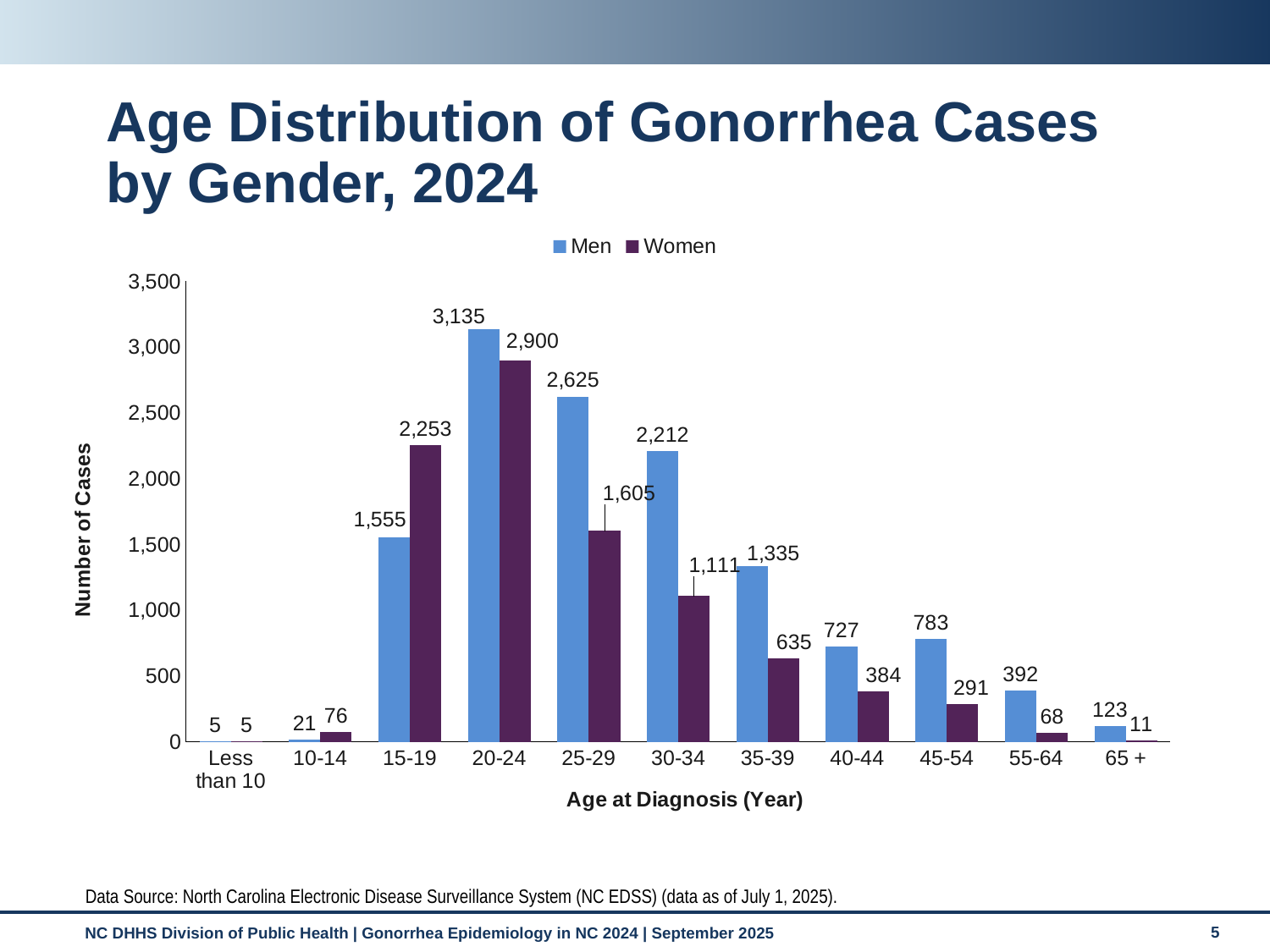
How many age groups are shown on the x axis? 11 Do the number of cases for men rise or fall from the 20-24 age group to the 65 + age group? Fall How many gonorrhea cases were reported among women aged 15-19? 2,253 What is the number of cases for women in the 35-39 age group? 635 Which age group has the highest number of cases among men? 20-24 How many gonorrhea cases were reported among men aged 20-24? 3,135 Which age group has the lowest number of cases among women? Less than 10 Is the value for men aged 45-54 greater or less than 500? greater How many series does the legend list? 2 In the 15-19 age group, which gender has more cases, men or women? Women What is the difference between men and women cases in the 25-29 age group? 1,020 What kind of chart is shown on the slide? Bar chart